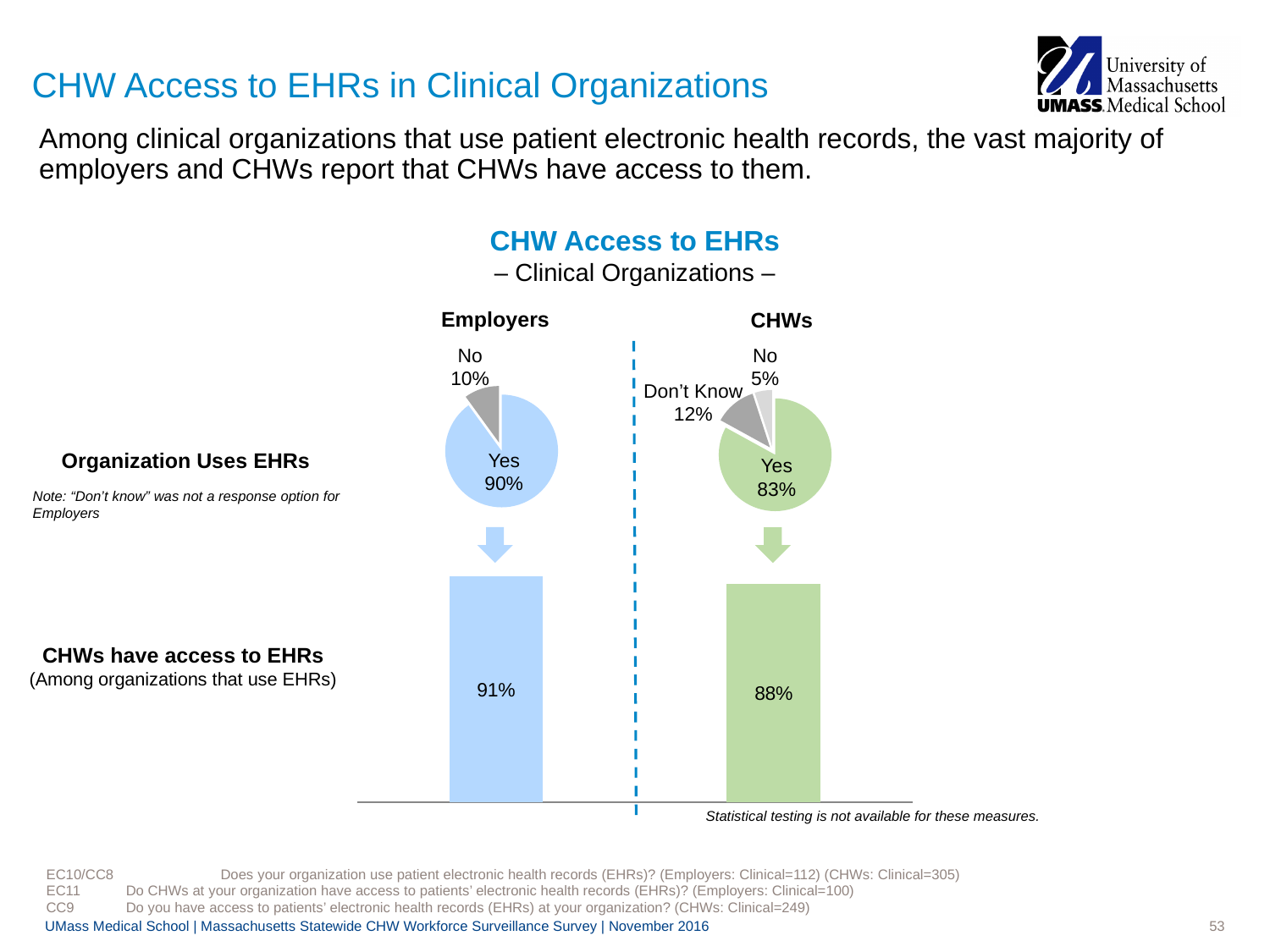
In the CHWs pie chart, what percentage answered No? 5% In the Employers pie chart, what percentage of organizations answered Yes to using EHRs? 90% In the bar chart for CHWs having access to EHRs, what is the value for CHWs? 88% What is the difference between the Yes share in the Employers pie chart and the Yes share in the CHWs pie chart? 7 percentage points In the bar chart for CHWs having access to EHRs, what is the difference between the Employers and CHWs values? 3 percentage points In the Employers pie chart, what percentage answered No? 10% How many slices does the CHWs pie chart have? 3 In the bar chart for CHWs having access to EHRs, which group has the higher value, Employers or CHWs? Employers In the CHWs pie chart, what percentage answered Yes to their organization using EHRs? 83% In the CHWs pie chart, what percentage answered Don't Know? 12% In the bar chart for CHWs having access to EHRs, what is the value for Employers? 91% In the CHWs pie chart, which response is the smallest slice? No